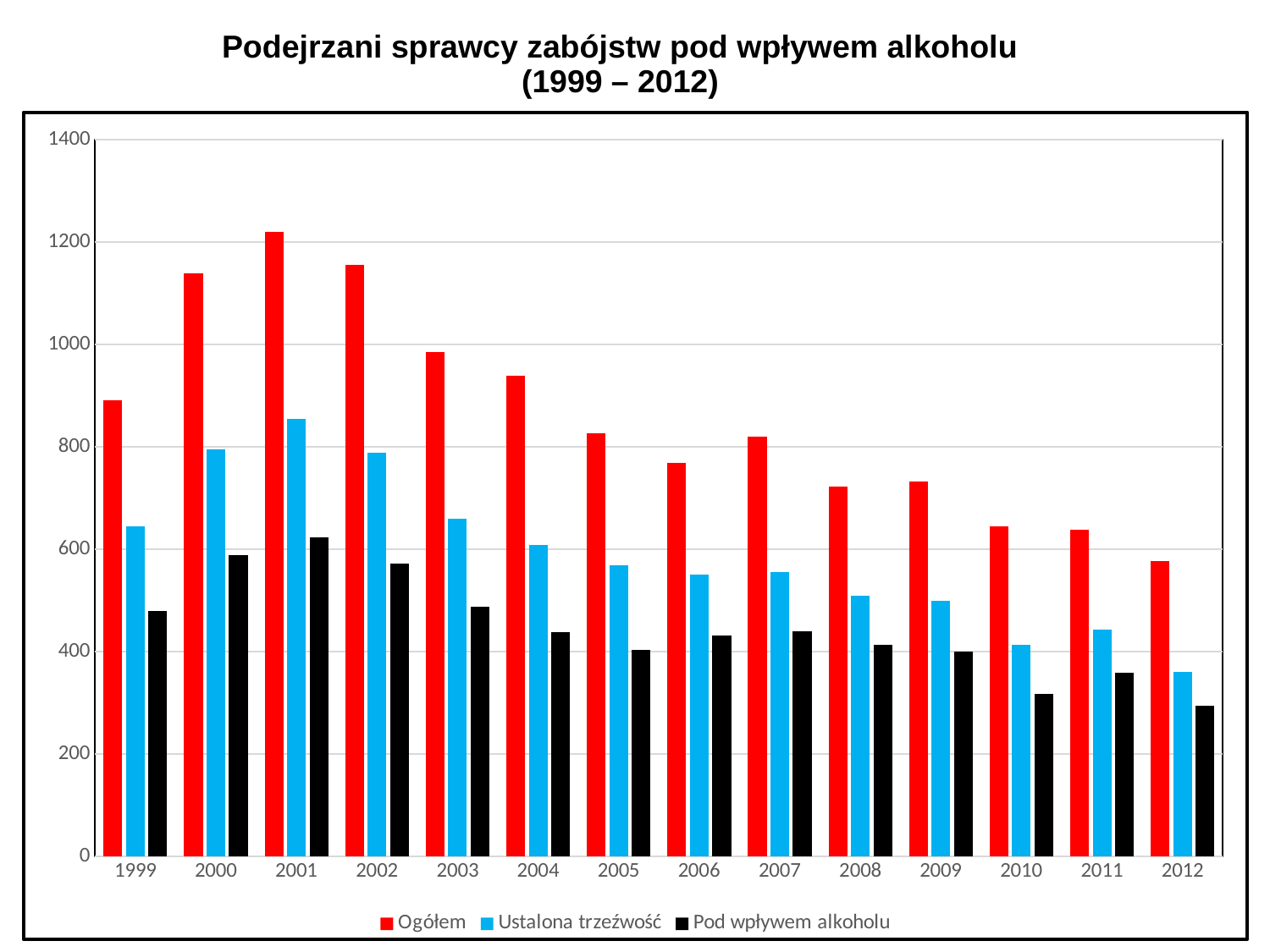
How many series does the legend list? 3 How many years are shown on the x axis? 14 In which year is the Ustalona trzeźwość value lowest? 2012 In which year is the Ogółem value lowest? 2012 Is the Ogółem value for 2001 greater or less than 1200? greater In which year is the Pod wpływem alkoholu value highest? 2001 Do the Ogółem values generally rise or fall from 2001 to 2012? fall In which year is the Ogółem value highest? 2001 What kind of chart is shown on the slide? bar chart Is the Ustalona trzeźwość value for 2001 greater or less than 800? greater Which year has the larger Ogółem value, 2006 or 2007? 2007 Is the Pod wpływem alkoholu value for 2010 greater or less than 400? less